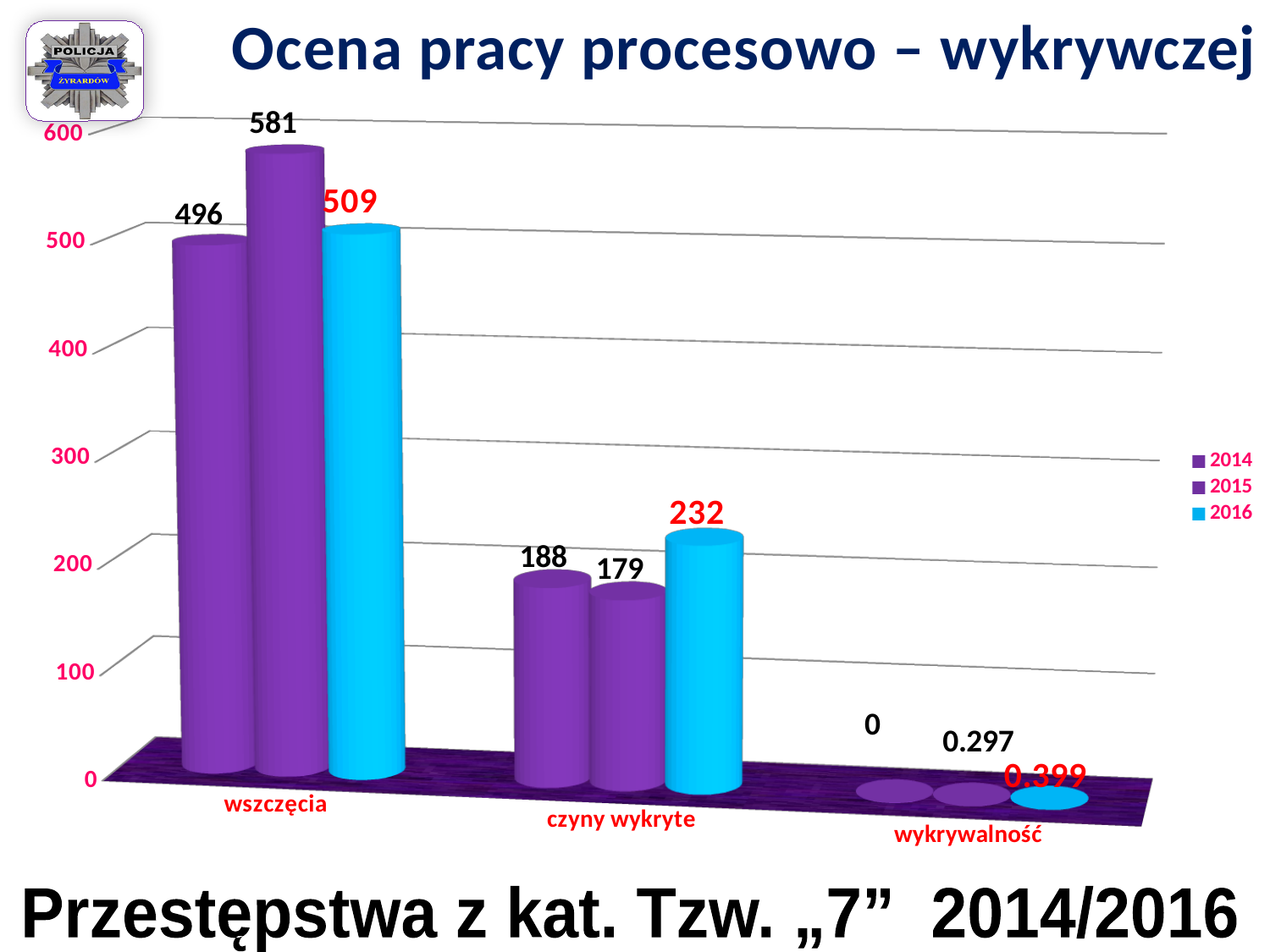
How many categories are shown on the x axis? 3 Which year has the lowest value in the czyny wykryte category? 2015 Which is larger in the wszczęcia category: the 2014 value or the 2016 value? 2016 Which year has the highest value in the wszczęcia category? 2015 What kind of chart is shown on the slide? bar chart What is the value for 2016 in the czyny wykryte category? 232 How many series does the legend list? 3 What is the value for 2015 in the wykrywalność category? 0.297 What is the difference between the 2016 and 2015 values in the czyny wykryte category? 53 What is the value for 2014 in the wykrywalność category? 0 What is the value for 2015 in the wszczęcia category? 581 What is the difference between the 2015 and 2014 values in the wszczęcia category? 85